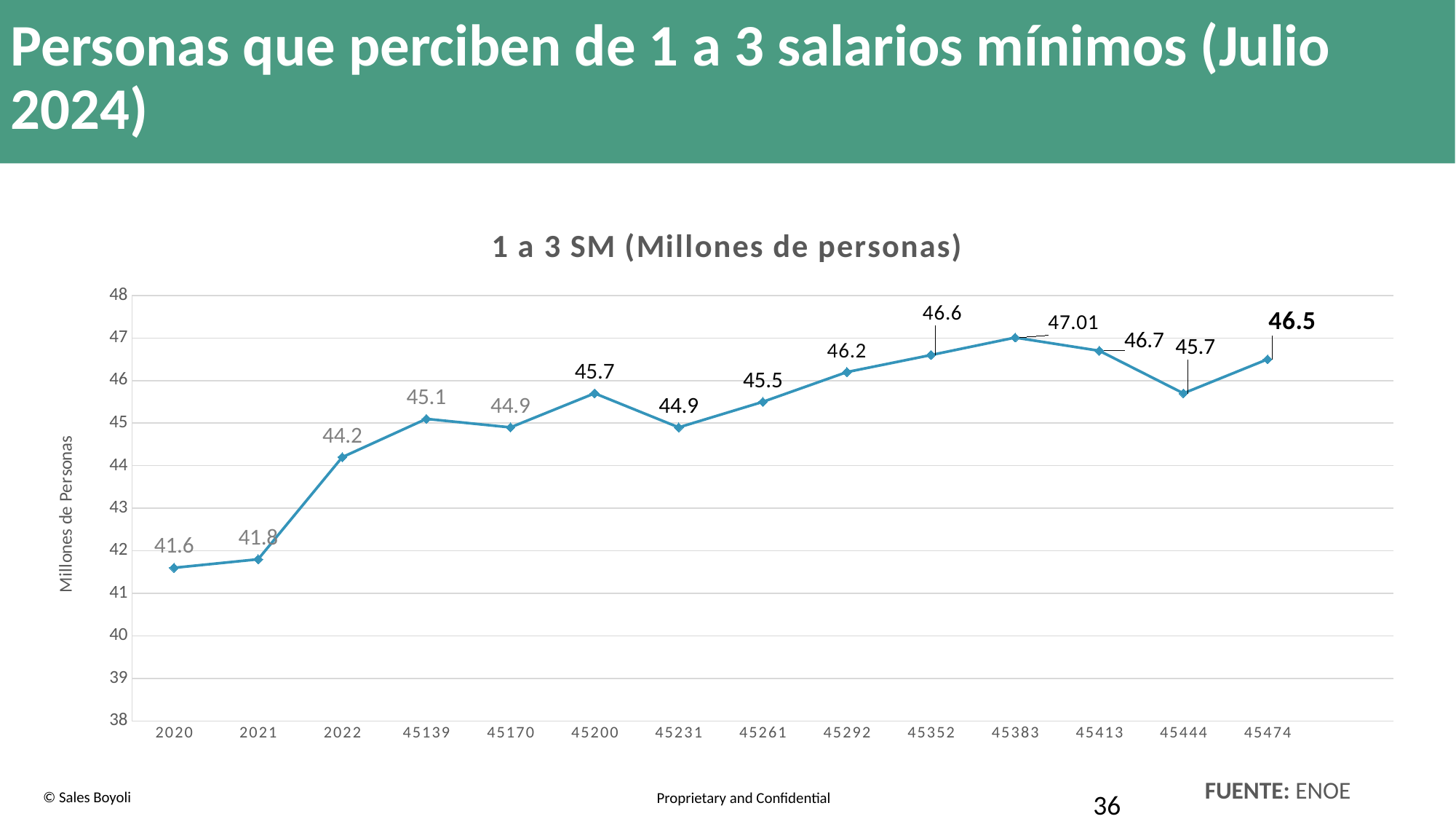
What is the value for the category labelled 45383? 47.01 Which is larger, the value for 45413 or the value for 45444? 45413 Which category has the lowest value? 2020 Which category has the highest value? 45383 Is the value for 2021 greater or less than 42? less How many data points are plotted on the chart? 14 What is the value for 2020? 41.6 What is the title of the chart? 1 a 3 SM (Millones de personas) What kind of chart is shown on the slide? line chart What is the difference between the values for 2022 and 2021? 2.4 What is the value for the last category, 45474? 46.5 What is the value for 2022? 44.2